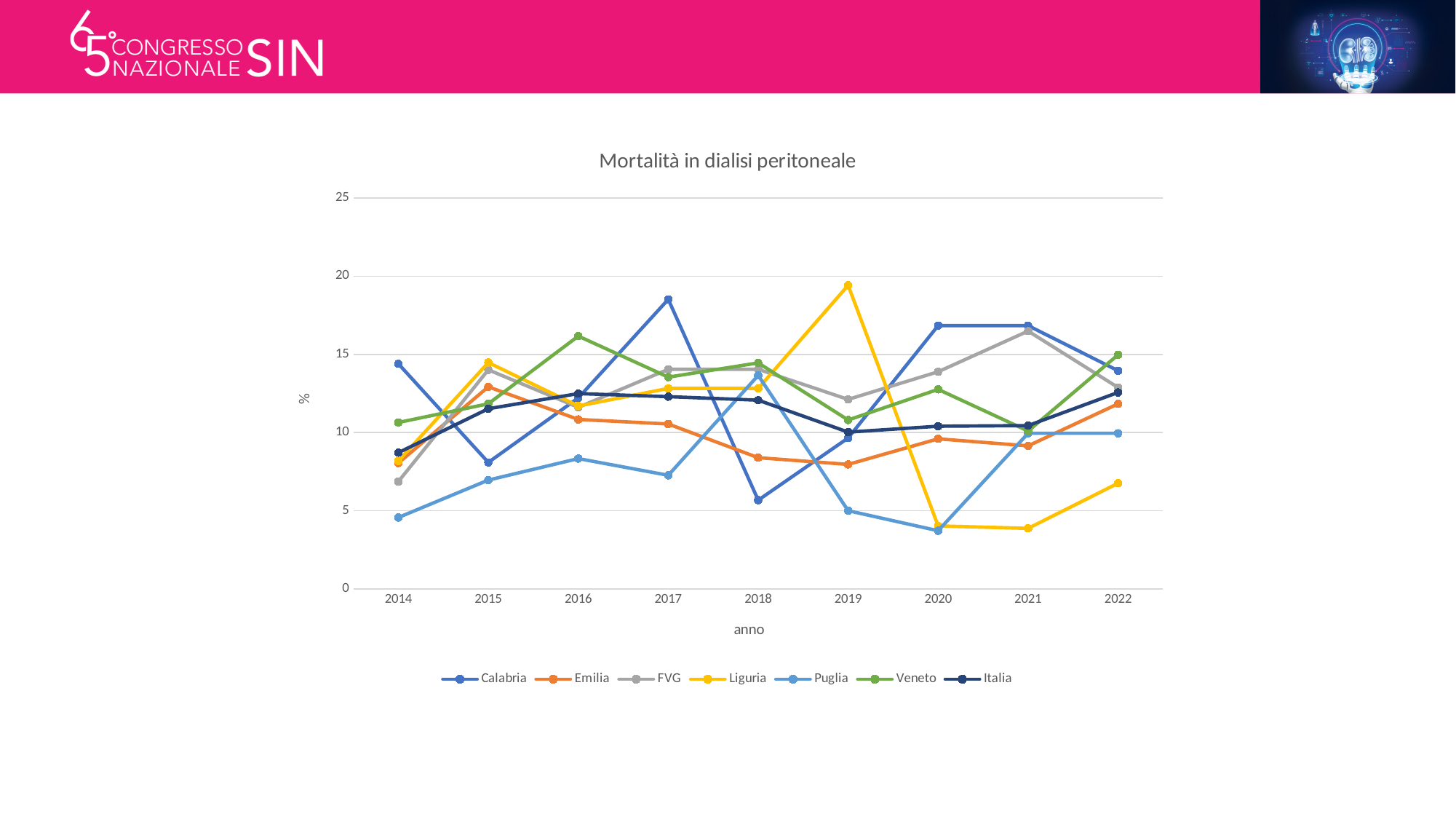
Is the value for Calabria in 2017 greater or less than 15? greater In which year does Calabria reach its lowest value? 2018 What is the label of the x axis? anno Is the value for Puglia in 2020 greater or less than 5? less How many series does the legend list? 7 How many years are shown on the x axis? 9 Which is larger in 2017, the value for Calabria or the value for Emilia? Calabria What is the title of the chart? Mortalità in dialisi peritoneale In which year does Liguria reach its highest value? 2019 Which series has the lowest value in 2019? Puglia What kind of chart is shown on the slide? line chart Which series has the highest value in 2019? Liguria